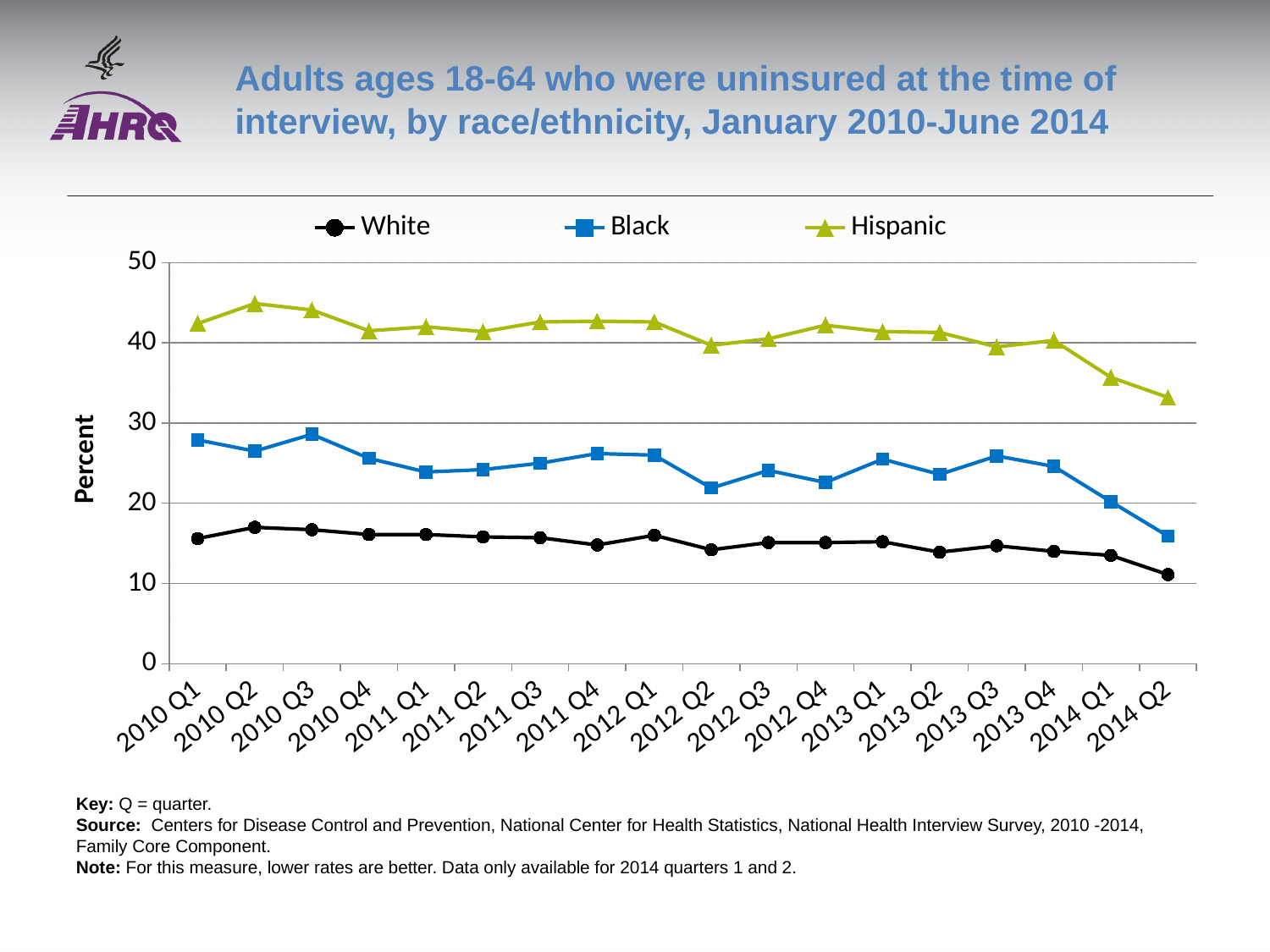
Is the value for Hispanic in 2014 Q2 greater or less than 30? greater Which race/ethnicity group has the lowest uninsured rate across the period? White Which is larger in 2012 Q1, the value for Hispanic or the value for Black? Hispanic What kind of chart is shown on the slide? line chart How many quarters are plotted along the x axis? 18 Which race/ethnicity group has the highest uninsured rate across the period? Hispanic Is the value for Hispanic in 2010 Q2 greater or less than 40? greater What is the label on the y axis? Percent How many series does the legend list? 3 Is the value for White in 2014 Q2 greater or less than 20? less Does the Hispanic line rise or fall from 2013 Q4 to 2014 Q2? fall